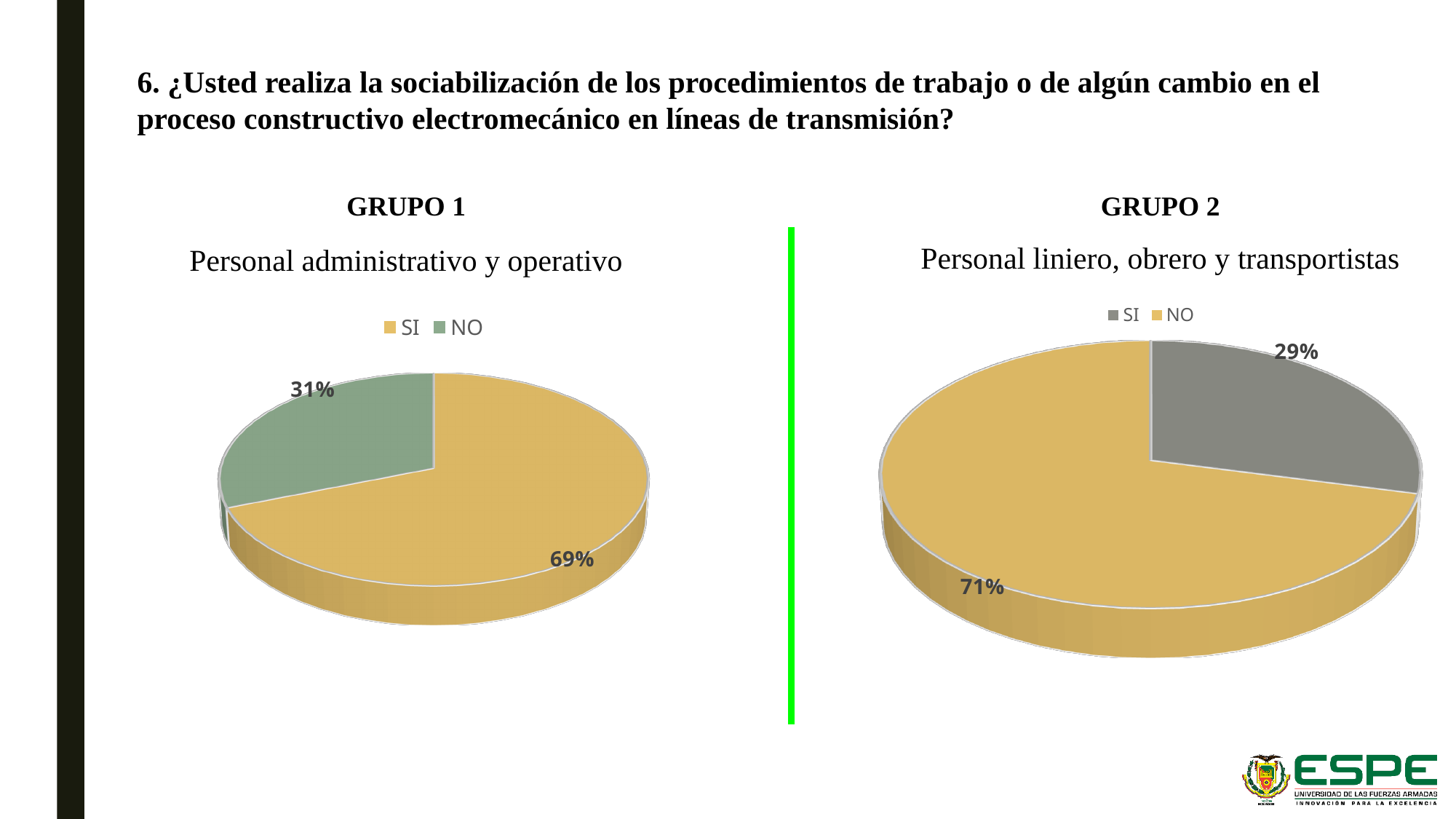
In the GRUPO 2 chart, which response has the smallest share? SI What type of chart is used for GRUPO 1? Pie chart In the GRUPO 1 chart, what is the difference in percentage points between SI and NO? 38 In the GRUPO 2 chart (Personal liniero, obrero y transportistas), what percentage answered NO? 71% In the GRUPO 1 chart (Personal administrativo y operativo), what percentage answered NO? 31% In the GRUPO 1 chart (Personal administrativo y operativo), what percentage answered SI? 69% In the GRUPO 1 chart, which response has the largest share? SI In the GRUPO 2 chart, what colour is the SI slice? Gray In the GRUPO 2 chart (Personal liniero, obrero y transportistas), what percentage answered SI? 29% How many entries does the legend of the GRUPO 2 chart list? 2 Which is larger: the SI share in the GRUPO 1 chart or the SI share in the GRUPO 2 chart? GRUPO 1 In the GRUPO 2 chart, what is the difference in percentage points between NO and SI? 42